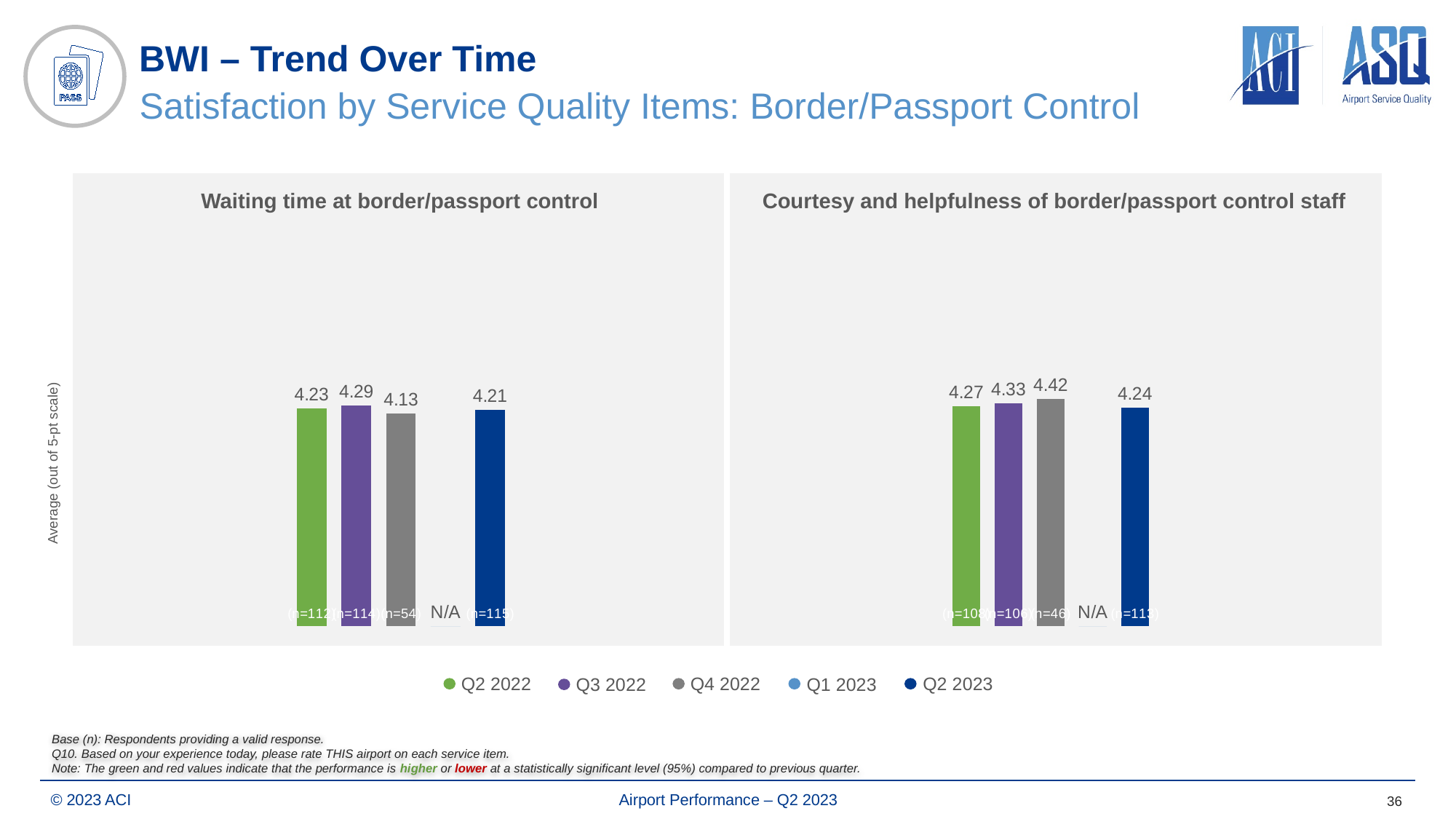
In the 'Waiting time at border/passport control' chart, what is the value for Q3 2022? 4.29 In the 'Courtesy and helpfulness of border/passport control staff' chart, which is larger, the Q3 2022 value or the Q2 2023 value? Q3 2022 How many series does the legend list? 5 In the 'Waiting time at border/passport control' chart, what is the value for Q2 2023? 4.21 In the 'Courtesy and helpfulness of border/passport control staff' chart, what is the value for Q2 2022? 4.27 In the 'Waiting time at border/passport control' chart, which quarter has the lowest value? Q4 2022 In the 'Courtesy and helpfulness of border/passport control staff' chart, which quarter has the highest value? Q4 2022 In the 'Waiting time at border/passport control' chart, what is the difference between the Q3 2022 and Q4 2022 values? 0.16 In the 'Courtesy and helpfulness of border/passport control staff' chart, what is the difference between the Q4 2022 and Q2 2023 values? 0.18 In the 'Waiting time at border/passport control' chart, what is shown for Q1 2023? N/A In the 'Courtesy and helpfulness of border/passport control staff' chart, what is the value for Q4 2022? 4.42 What kind of chart is the 'Waiting time at border/passport control' chart? Bar chart